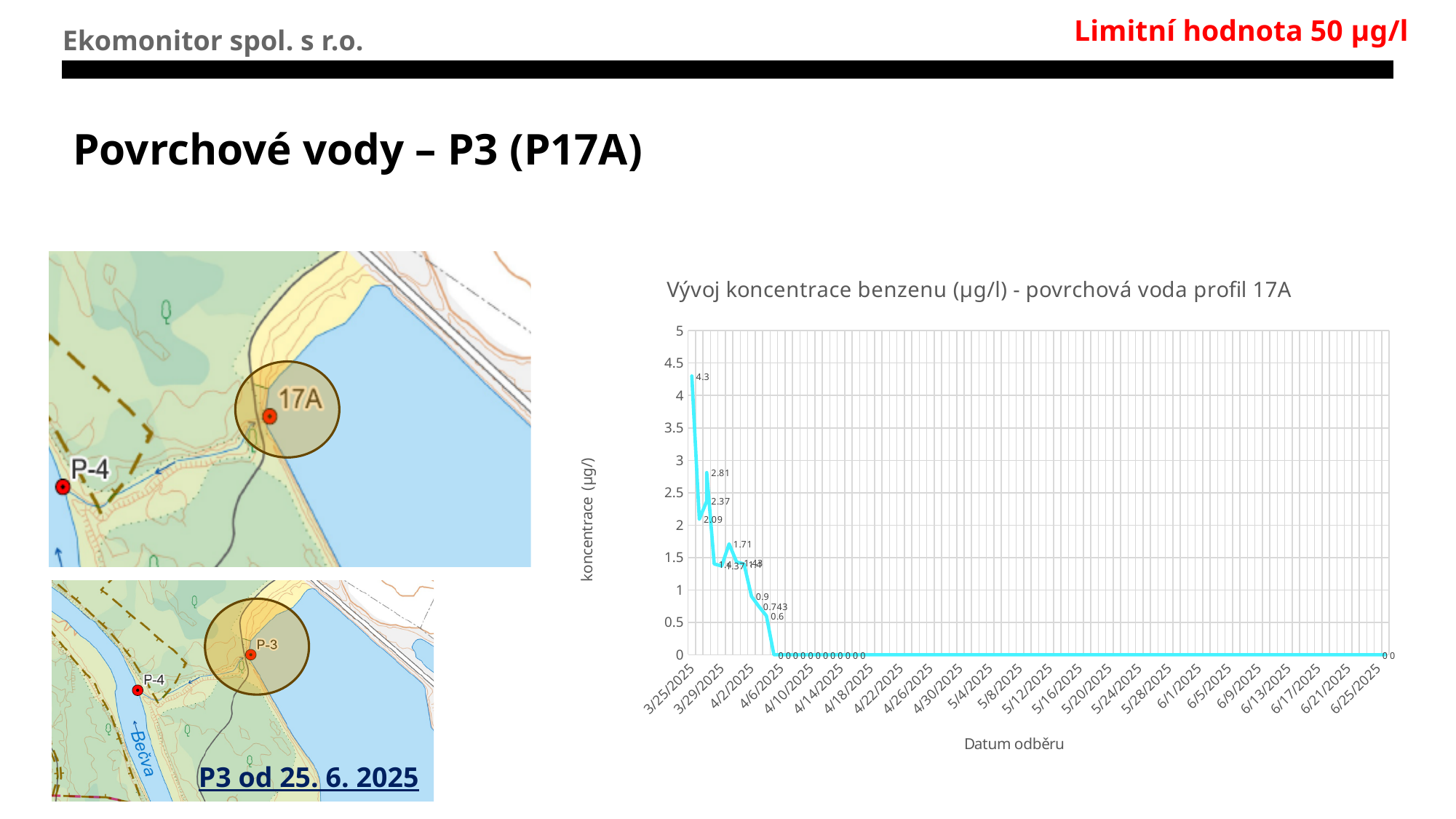
Is the highest value on the chart greater or less than 5? less What is the label of the x axis of the chart? Datum odběru What is the difference between the highest labelled value (4.3) and the second-highest labelled value (2.81)? 1.49 What is the maximum value shown on the y axis? 5 Do the benzene concentration values generally rise or fall along the x axis? fall What is the benzene concentration value at the first point, 3/25/2025? 4.3 What is the highest benzene concentration value labelled on the chart? 4.3 What is the title of the chart? Vývoj koncentrace benzenu (µg/l) - povrchová voda profil 17A Is the benzene concentration at 3/25/2025 greater or less than 4? greater What value do the points from mid-April 2025 onward show? 0 What kind of chart is shown on the slide? line chart